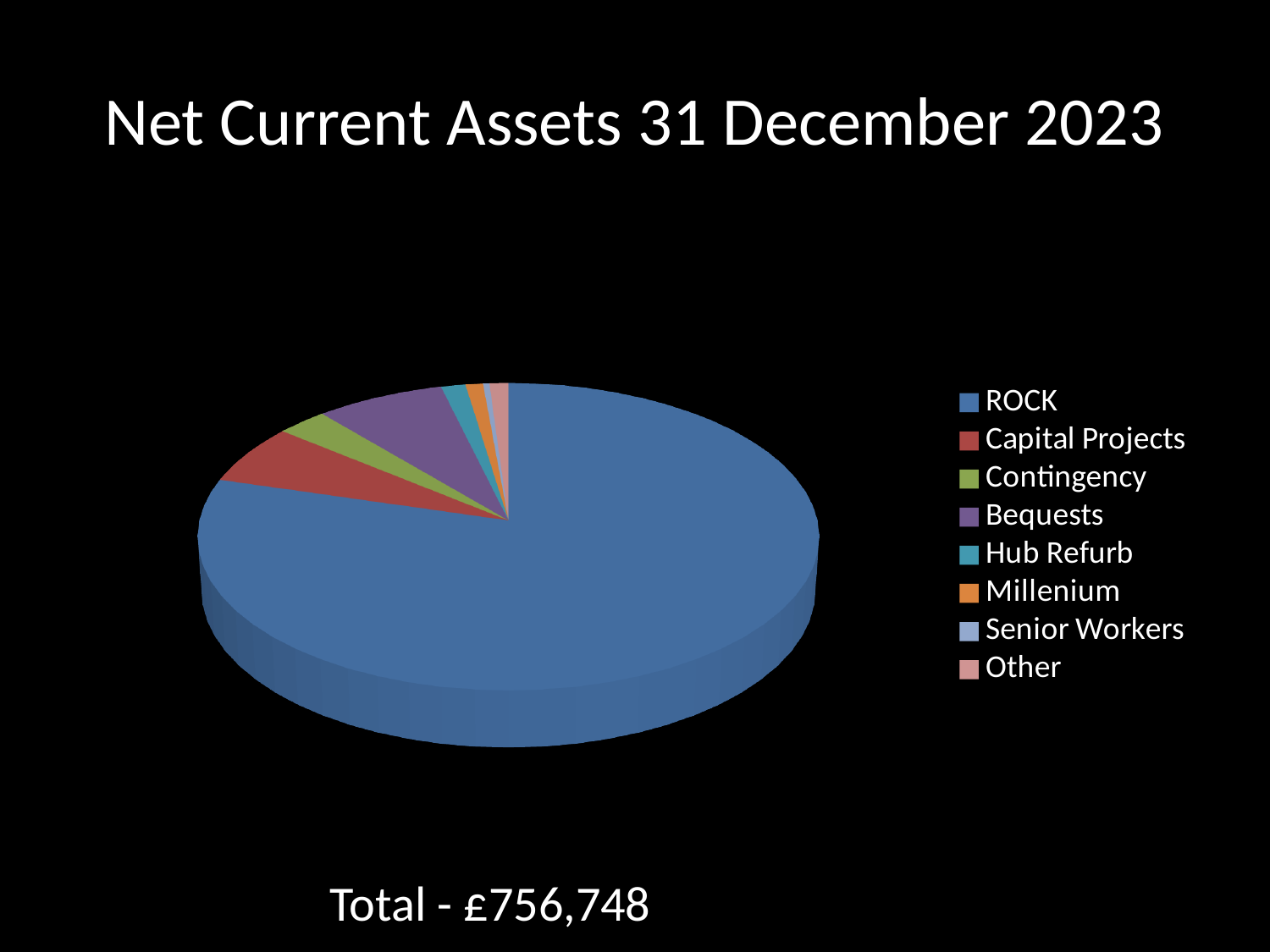
Which category is listed last in the legend? Other Which slice is larger, Bequests or Contingency? Bequests Which slice is larger, ROCK or Capital Projects? ROCK Which category has the largest slice of the pie? ROCK How many categories does the pie chart's legend list? 8 Which slice is larger, Capital Projects or Contingency? Capital Projects What total is stated below the pie chart? £756,748 What is the title of the chart on the slide? Net Current Assets 31 December 2023 What kind of chart is shown on the slide? Pie chart What colour is the ROCK slice in the pie chart? Blue Does the ROCK slice account for more or less than half of the pie? more